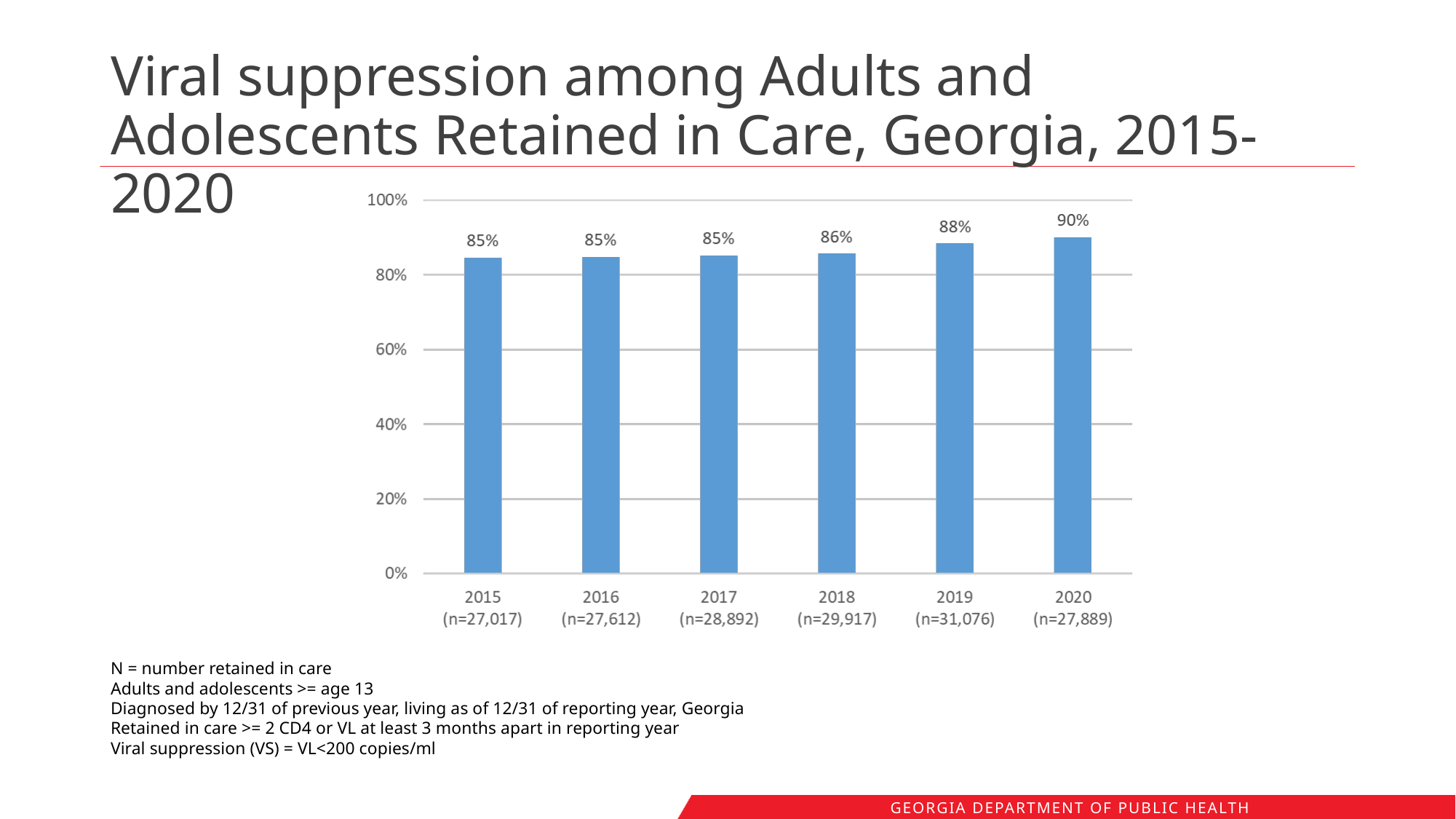
What is the number retained in care (n) shown for 2019? n=31,076 What is the difference in viral suppression percentage between 2020 and 2015? 5% Which year has a higher viral suppression percentage, 2019 or 2017? 2019 What is the viral suppression percentage for 2020? 90% Is the viral suppression value for 2016 greater or less than 80%? greater How many years are shown on the x axis of the chart? 6 What kind of chart is shown on the slide? Bar chart Which year has the highest viral suppression percentage? 2020 Do the viral suppression percentages rise or fall from 2015 to 2020? Rise What is the viral suppression percentage for 2018? 86% What is the difference in viral suppression percentage between 2019 and 2018? 2% What is the viral suppression percentage for 2015? 85%